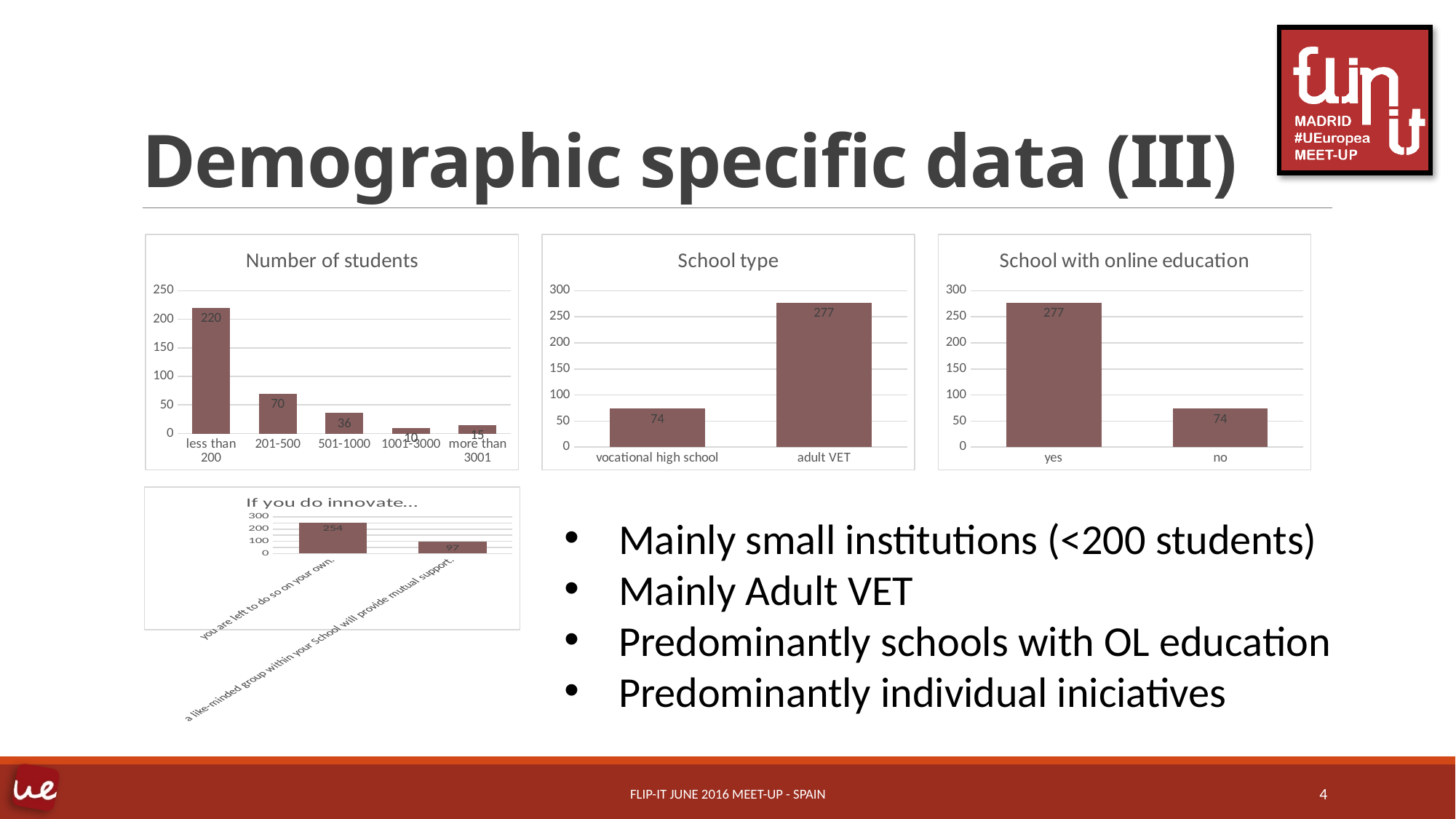
In the 'Number of students' chart, how many categories are shown? 5 In the 'Number of students' chart, what is the value for 'less than 200'? 220 In the 'If you do innovate...' chart, what is the value for 'a like-minded group within your School will provide mutual support'? 97 In the 'School with online education' chart, what is the difference between 'yes' and 'no'? 203 In the 'School type' chart, which category is higher, 'vocational high school' or 'adult VET'? adult VET What type of chart is the 'School type' chart? bar chart In the 'School type' chart, what is the value for 'adult VET'? 277 In the 'Number of students' chart, what is the difference between 'less than 200' and '201-500'? 150 In the 'Number of students' chart, is the value for '501-1000' greater or less than 50? less In the 'School with online education' chart, what is the value for 'no'? 74 In the 'If you do innovate...' chart, what is the value for 'you are left to do so on your own'? 254 In the 'Number of students' chart, which category has the lowest value? 1001-3000